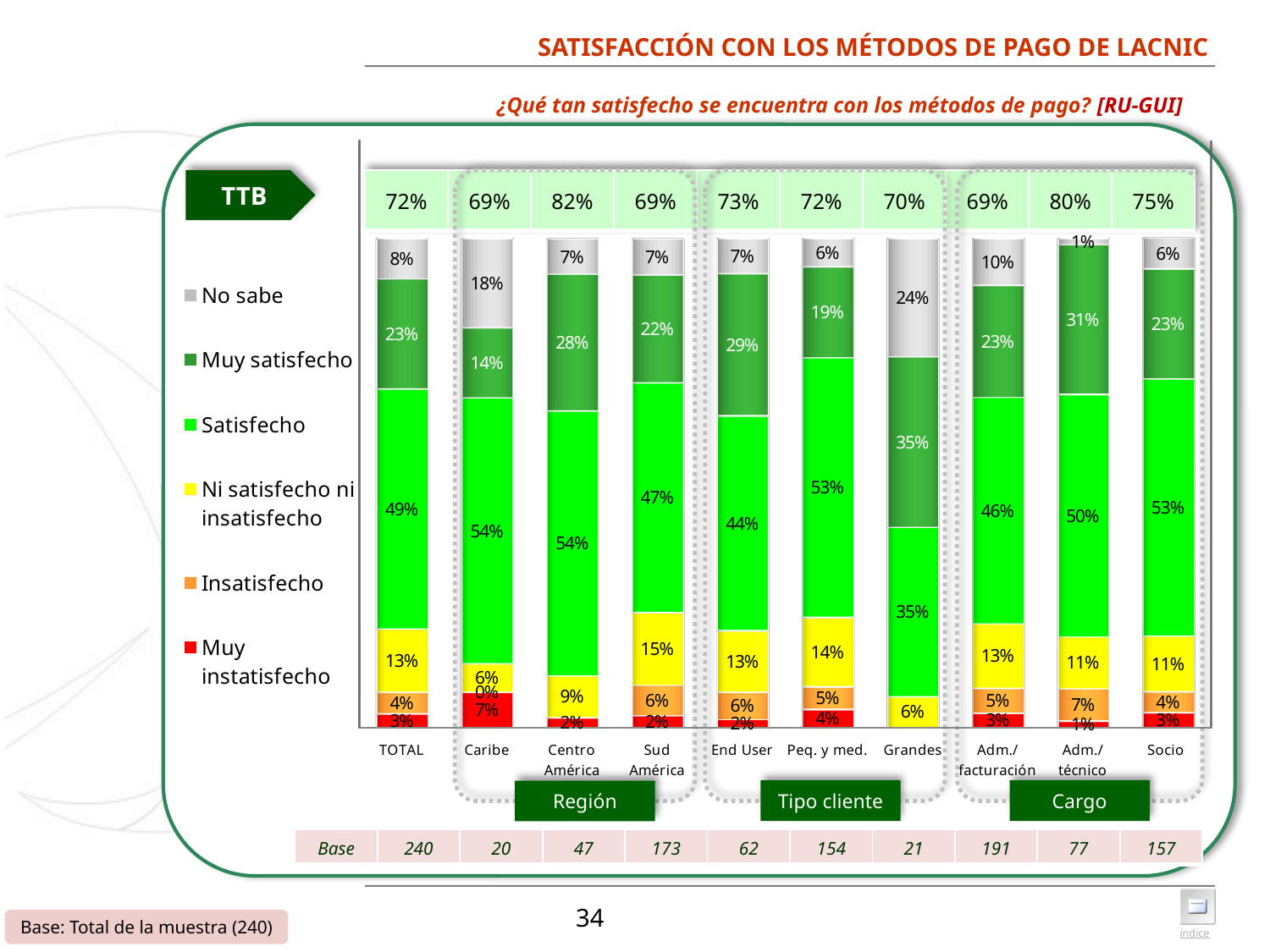
Which category has the highest Muy satisfecho percentage? Grandes Which category has the lowest Satisfecho percentage? Grandes How many percentage points higher is Muy satisfecho for TOTAL than for Caribe? 9 How many categories are shown along the x axis of the chart? 10 What percentage of TOTAL respondents are Satisfecho? 49% What is the Muy satisfecho percentage for Adm./técnico? 31% What is the Ni satisfecho ni insatisfecho percentage for Sud América? 15% What is the No sabe percentage for Grandes? 24% How many series does the legend list? 6 Which has a larger Satisfecho percentage, End User or Sud América? Sud América What kind of chart is shown on the slide? Stacked bar chart What is the TTB value shown above the Centro América bar? 82%